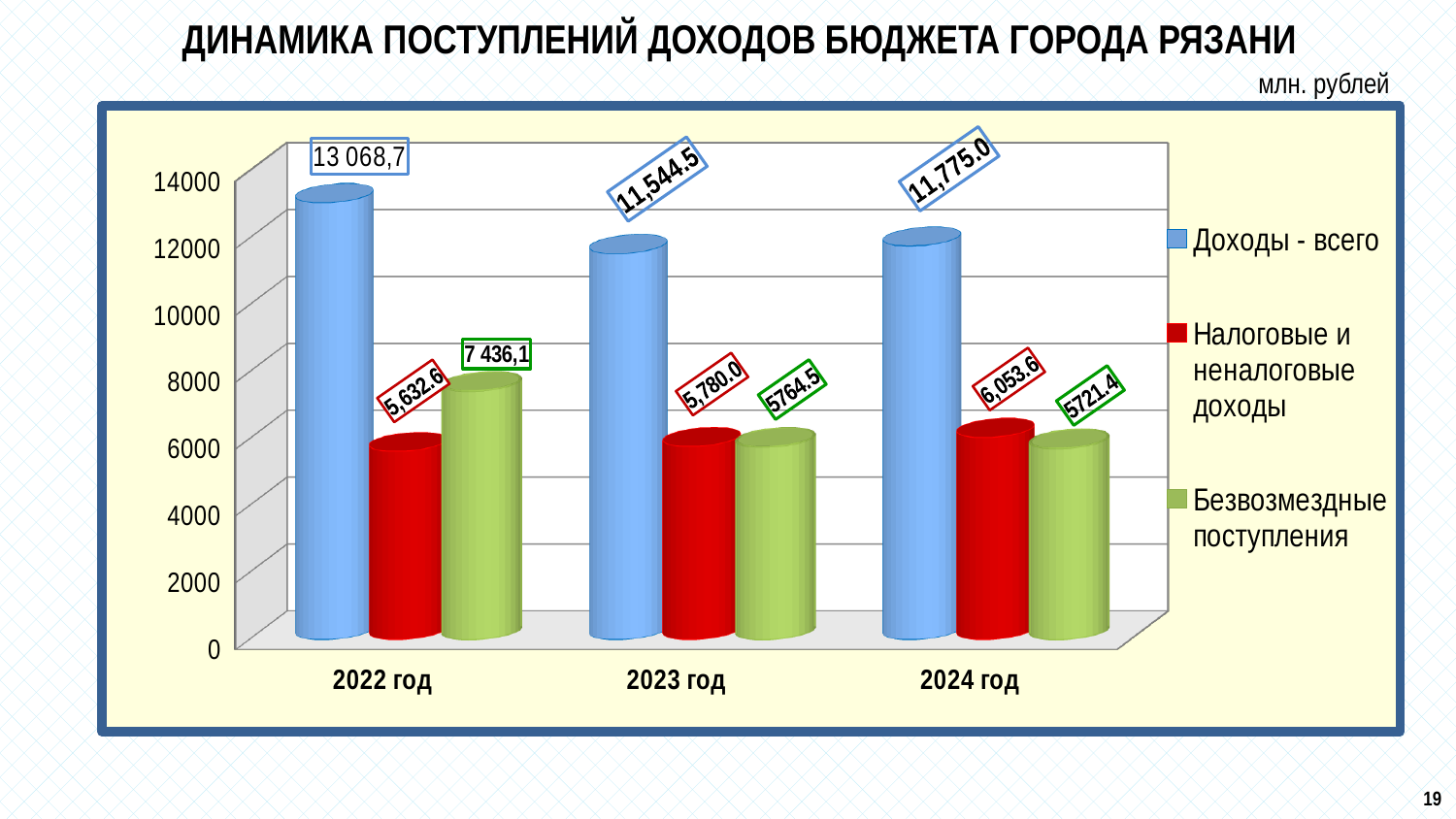
What is the difference between Доходы - всего in 2024 год and in 2023 год? 230.5 How many series does the legend list? 3 What kind of chart is shown on the slide? bar chart What is the value for Безвозмездные поступления in 2023 год? 5764.5 What is the value for Доходы - всего in 2022 год? 13 068,7 In which year is Доходы - всего the highest? 2022 год What is the value for Налоговые и неналоговые доходы in 2024 год? 6,053.6 How many years are shown on the x axis? 3 Which is larger in 2022 год: Налоговые и неналоговые доходы or Безвозмездные поступления? Безвозмездные поступления Is the value for Доходы - всего in 2024 год greater or less than 12000? less What is the value for Доходы - всего in 2023 год? 11,544.5 In which year is Налоговые и неналоговые доходы the lowest? 2022 год